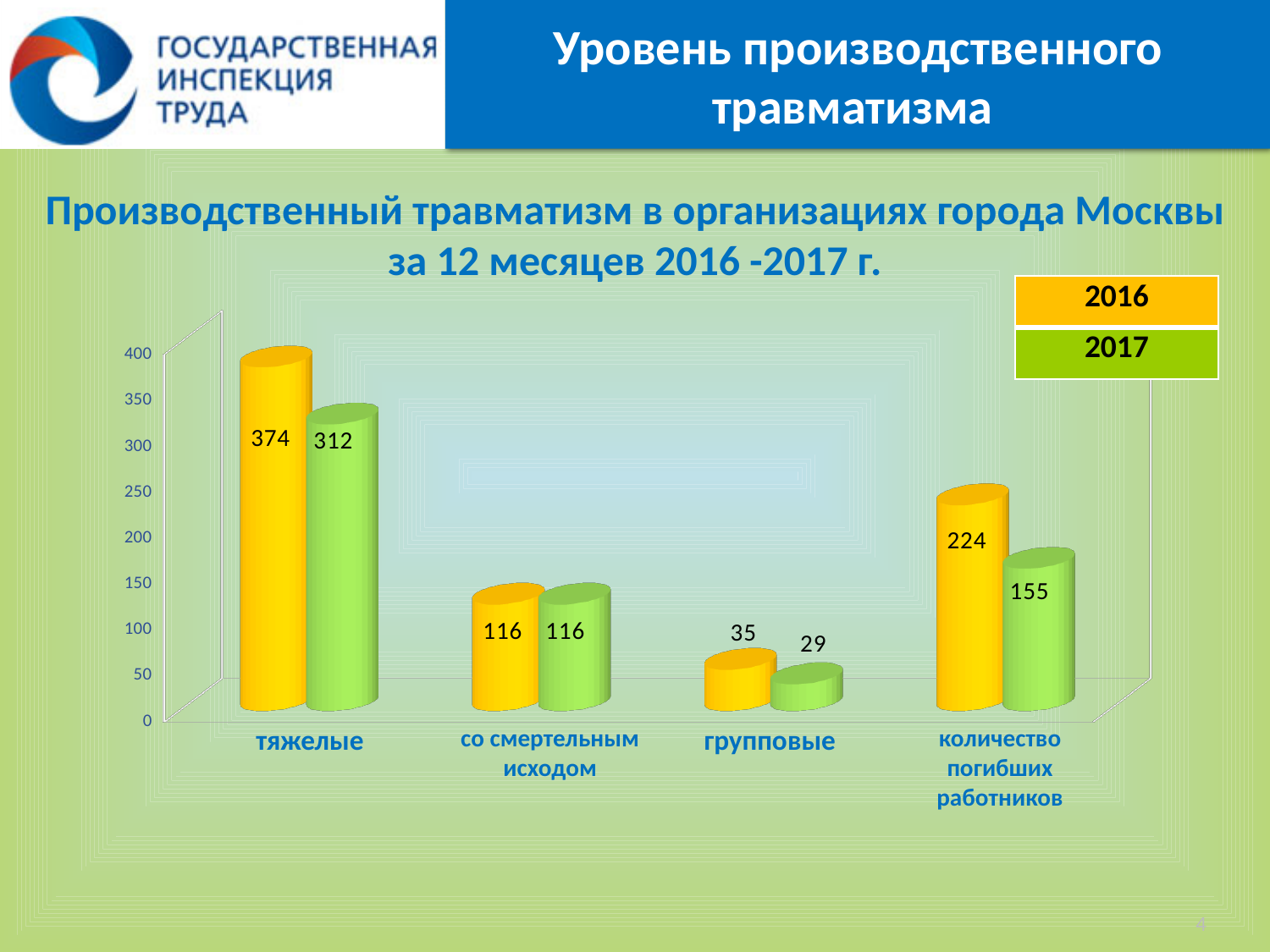
What is the 2017 value for "количество погибших работников"? 155 How many categories are shown on the x axis? 4 What kind of chart is shown on the slide? bar chart What is the difference between the 2016 and 2017 values for "количество погибших работников"? 69 What is the difference between the 2016 and 2017 values for "тяжелые"? 62 What is the 2016 value for the category "тяжелые"? 374 Which category has the highest 2016 value? тяжелые Which is larger for "групповые": the 2016 value or the 2017 value? 2016 How many series does the legend list? 2 Which category has the lowest 2017 value? групповые What is the 2016 value for "групповые"? 35 What is the 2017 value for the category "тяжелые"? 312